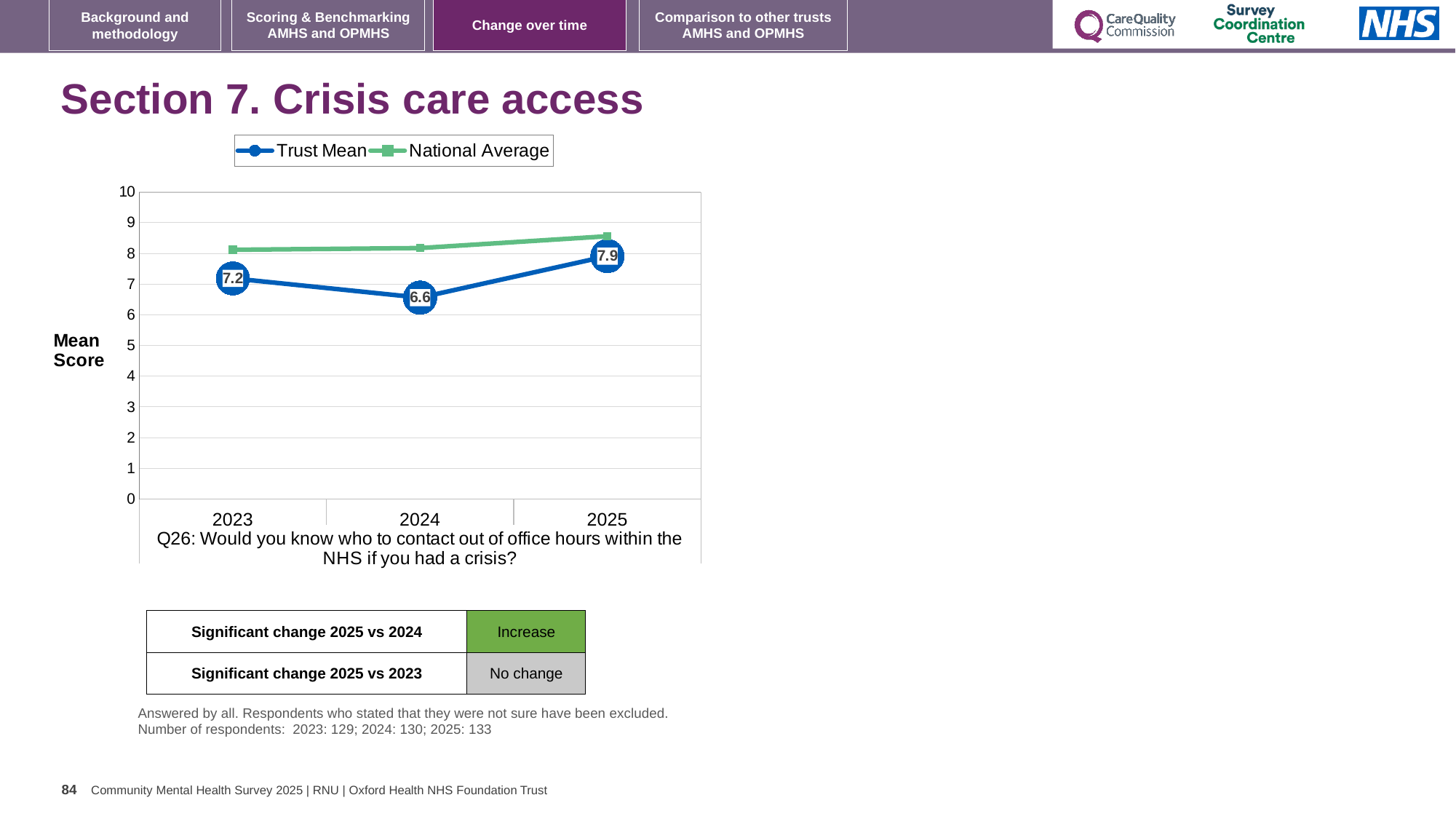
By how much did the Trust Mean change from 2024 to 2025? 1.3 What is the Trust Mean score for 2025? 7.9 In which year is the Trust Mean lowest? 2024 What is the Trust Mean score for 2023? 7.2 Is the National Average for 2025 greater or less than 8? greater What is the Trust Mean score for 2024? 6.6 In 2024, which is higher: the Trust Mean or the National Average? National Average In which year is the Trust Mean highest? 2025 How many series does the legend list? 2 Does the Trust Mean rise or fall from 2023 to 2024? fall What kind of chart is shown on the slide? line chart How many years are shown on the x axis? 3